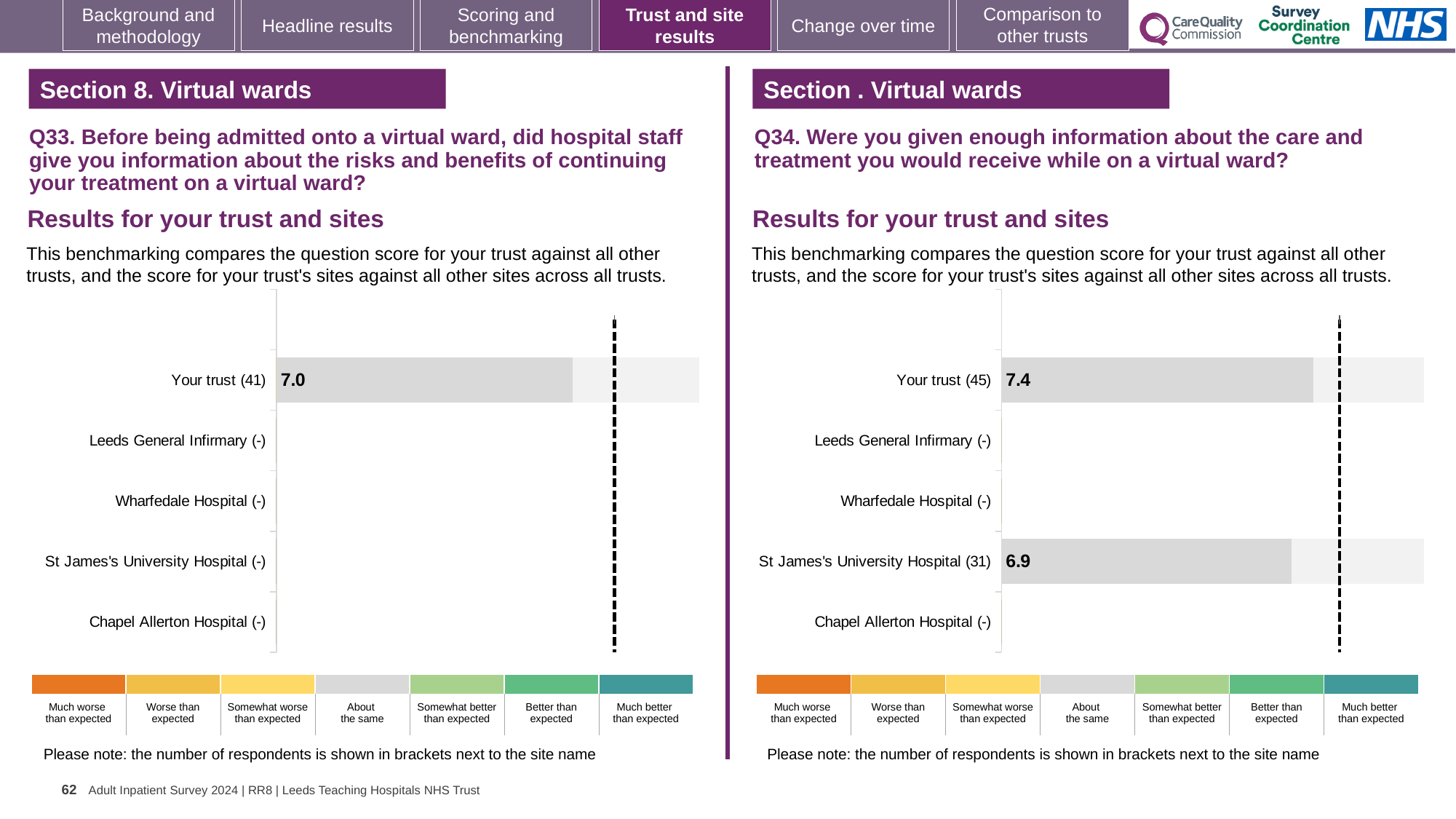
In the Q34 chart on the right, which is higher: the score for Your trust or for St James's University Hospital? Your trust How many benchmark categories are shown in the colour key below each chart, from 'Much worse than expected' to 'Much better than expected'? 7 In the Q33 chart on the left, how many respondents are shown in brackets next to Your trust? 41 What type of chart is used for the Q33 results on the left? Bar chart How many site or trust categories are listed on the y axis of the Q33 chart on the left? 5 In the Q34 chart on the right, what is the score for Your trust? 7.4 In the Q34 chart on the right, how many categories have a plotted bar with a score? 2 In the Q34 chart on the right, what is the difference between the score for Your trust and the score for St James's University Hospital? 0.5 In the Q34 chart on the right, how many respondents are shown in brackets next to St James's University Hospital? 31 In the Q34 chart on the right, what is the score for St James's University Hospital? 6.9 In the Q33 chart on the left, what is the score for Your trust? 7.0 Which chart shows a higher score for Your trust, the Q33 chart on the left or the Q34 chart on the right? Q34 chart on the right